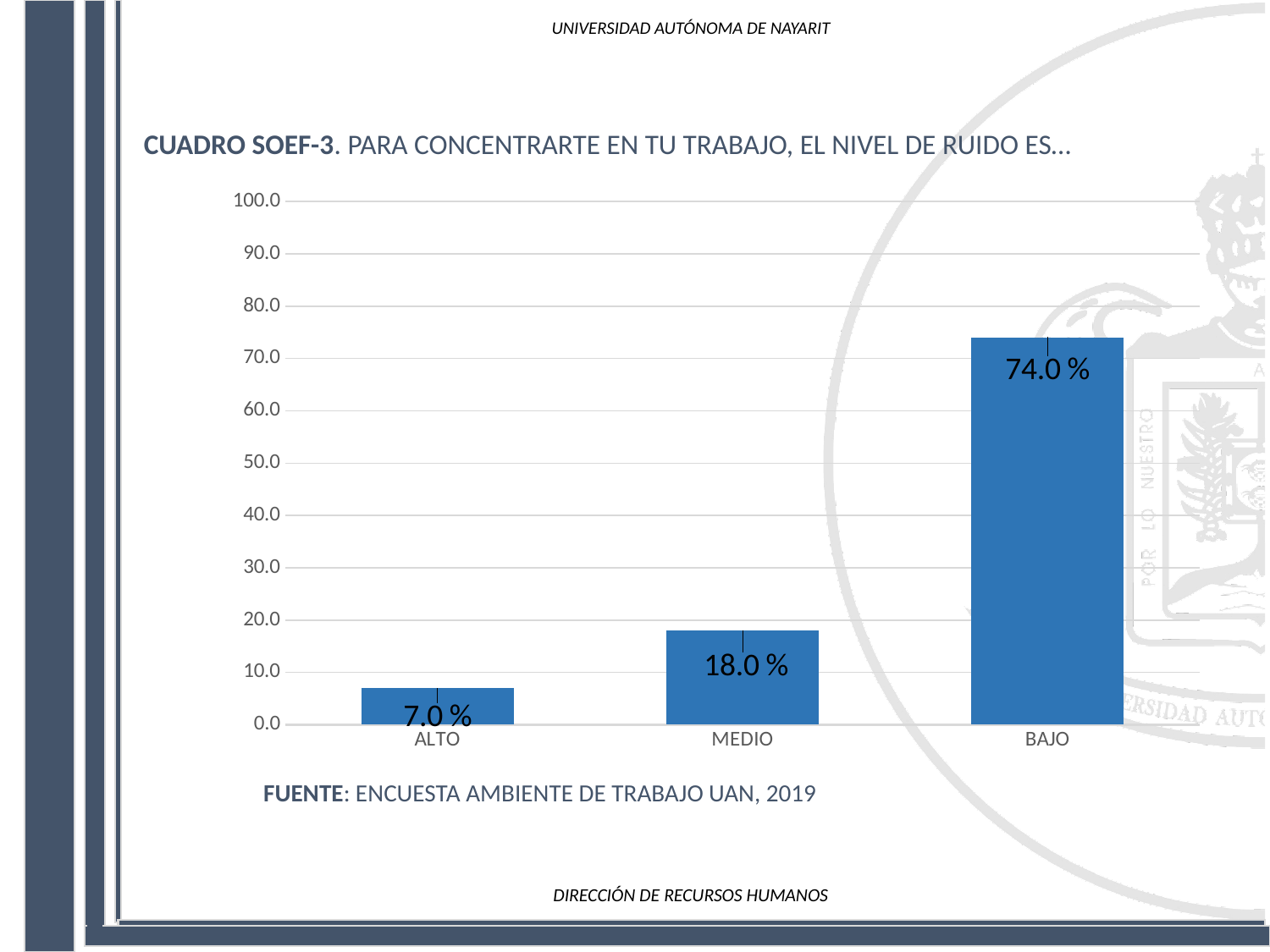
What is the value for MEDIO? 18.0 % How many categories are shown on the x axis? 3 Is the value for BAJO greater or less than 70.0? greater Which category has the lowest value? ALTO What is the difference between the values for MEDIO and ALTO? 11.0 % What source is cited below the chart? ENCUESTA AMBIENTE DE TRABAJO UAN, 2019 What is the difference between the values for BAJO and MEDIO? 56.0 % What is the value for BAJO? 74.0 % What kind of chart is shown on the slide? bar chart Which is larger, the value for MEDIO or the value for ALTO? MEDIO What is the value for ALTO? 7.0 % Which category has the highest value? BAJO